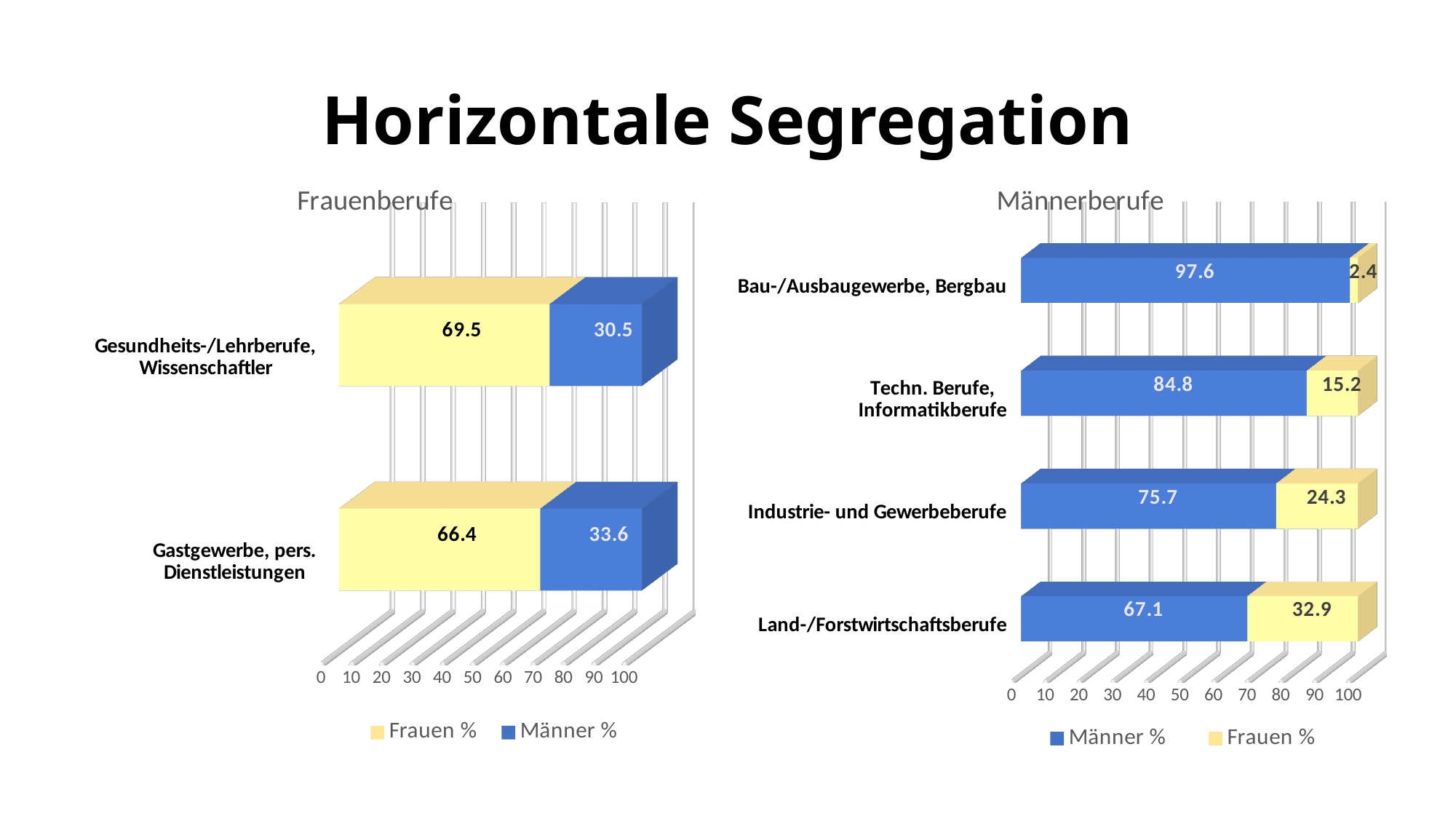
What kind of chart is the Männerberufe chart? Stacked bar chart How many categories are shown in the Männerberufe chart? 4 In the Männerberufe chart, which category has the highest Männer % value? Bau-/Ausbaugewerbe, Bergbau In the Männerberufe chart, what is the difference between the Männer % values for Techn. Berufe, Informatikberufe and Land-/Forstwirtschaftsberufe? 17.7 In the Männerberufe chart, what is the Männer % value for Bau-/Ausbaugewerbe, Bergbau? 97.6 How many series does the legend of the Frauenberufe chart list? 2 In the Frauenberufe chart, which category has the larger Frauen % value: Gesundheits-/Lehrberufe, Wissenschaftler or Gastgewerbe, pers. Dienstleistungen? Gesundheits-/Lehrberufe, Wissenschaftler In the Männerberufe chart, which category has the lowest Frauen % value? Bau-/Ausbaugewerbe, Bergbau In the Frauenberufe chart, what is the Frauen % value for Gesundheits-/Lehrberufe, Wissenschaftler? 69.5 In the Frauenberufe chart, what is the Männer % value for Gastgewerbe, pers. Dienstleistungen? 33.6 In the Männerberufe chart, what is the total of the stacked bar for Land-/Forstwirtschaftsberufe? 100 In the Männerberufe chart, what is the Frauen % value for Industrie- und Gewerbeberufe? 24.3